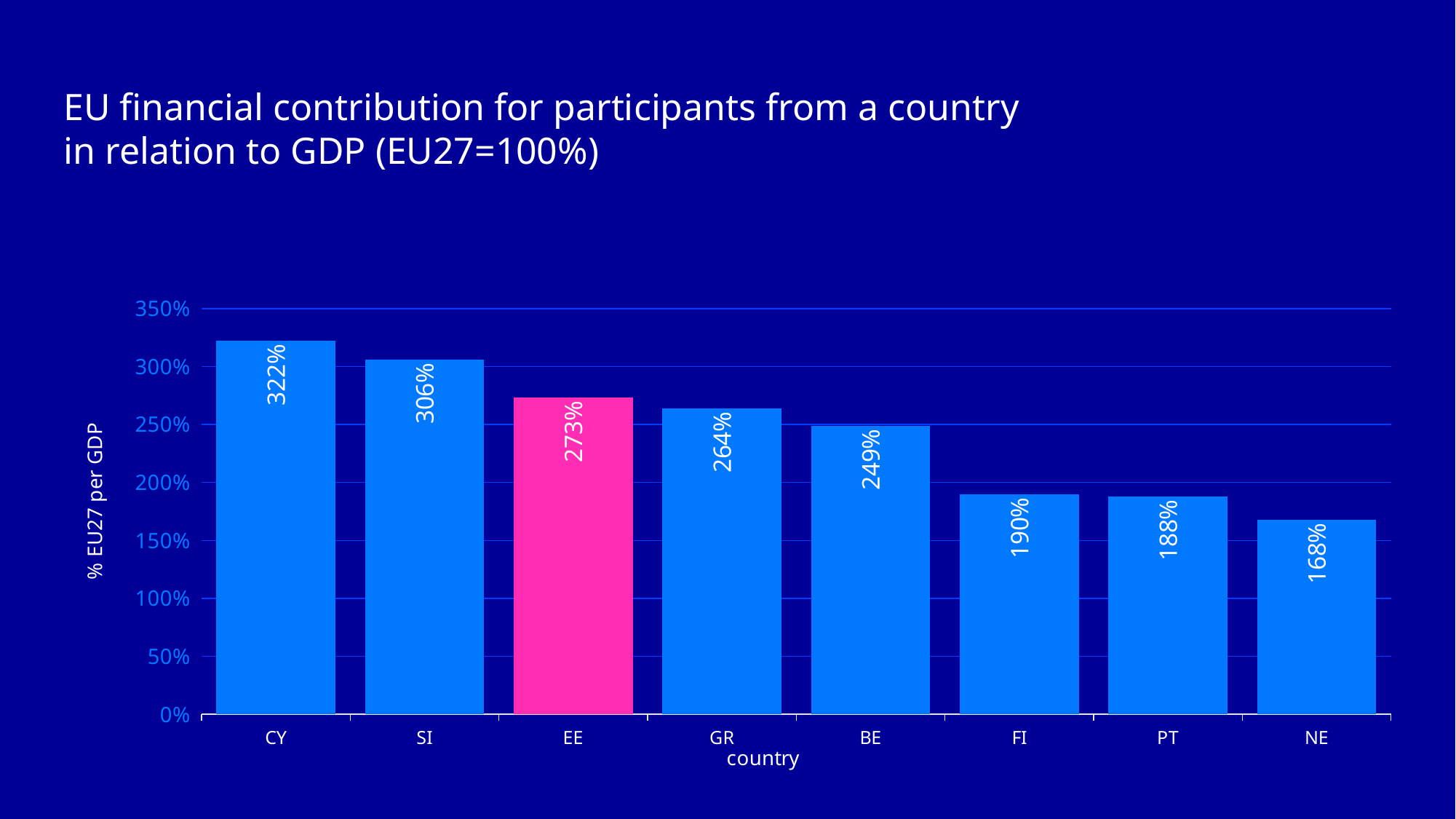
What is the value for EE? 273% Which country's bar is highlighted in pink? EE What is the difference between the values for CY and SI? 16% Which is larger, the value for SI or the value for GR? SI Which country has the highest value? CY What is the difference between the values for GR and NE? 96% How many countries are shown on the x axis? 8 What is the value for BE? 249% Is the value for FI greater or less than 200%? less What kind of chart is shown on the slide? bar chart Which country has the lowest value? NE What is the value for NE? 168%